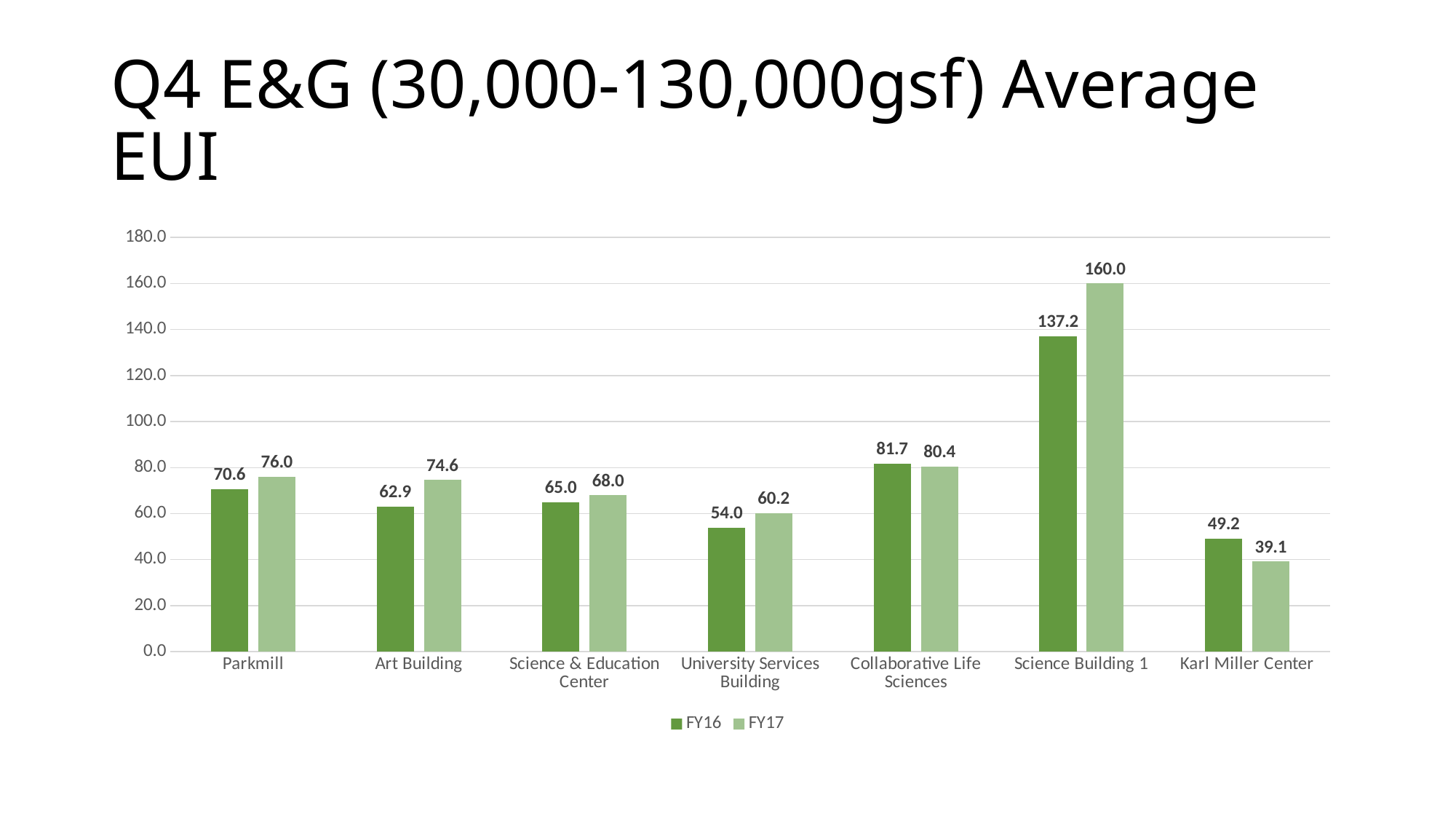
What is the FY17 value for Science Building 1? 160.0 What kind of chart is shown on the slide? Bar chart Which building has the highest FY16 value? Science Building 1 What is the FY17 value for Karl Miller Center? 39.1 How many buildings are shown on the x axis? 7 What is the FY16 value for University Services Building? 54.0 Is the FY16 value for Art Building greater or less than 80.0? less What is the difference between the FY17 and FY16 values for Science Building 1? 22.8 How many series does the legend list? 2 Which building has the lowest FY17 value? Karl Miller Center Which is larger for Collaborative Life Sciences, the FY16 value or the FY17 value? FY16 What is the title of the chart on the slide? Q4 E&G (30,000-130,000gsf) Average EUI